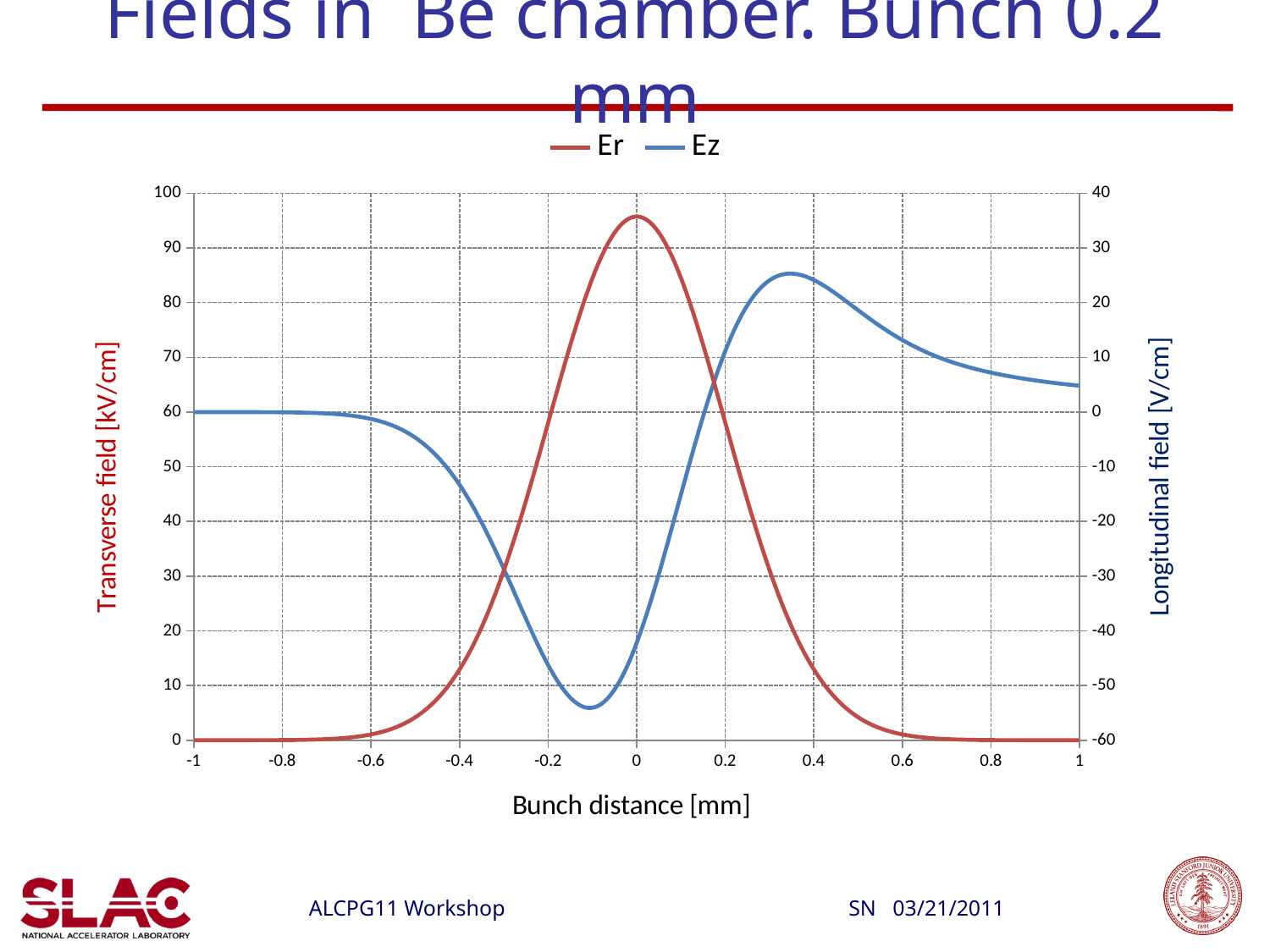
At which bunch distance does Er reach its maximum? 0 Does Ez rise or fall as bunch distance goes from -0.6 to -0.1? fall Is the maximum value of Ez greater or less than 20 V/cm? greater Is the value of Er at bunch distance 0 greater or less than 90 kV/cm? greater Is the value of Er at bunch distance -1 greater or less than 10 kV/cm? less What are the two series named in the legend? Er and Ez What kind of chart is shown on the slide? line chart What is the title of the x axis? Bunch distance [mm] How many series does the legend list? 2 Does Er rise or fall as bunch distance goes from -1 to 0? rise